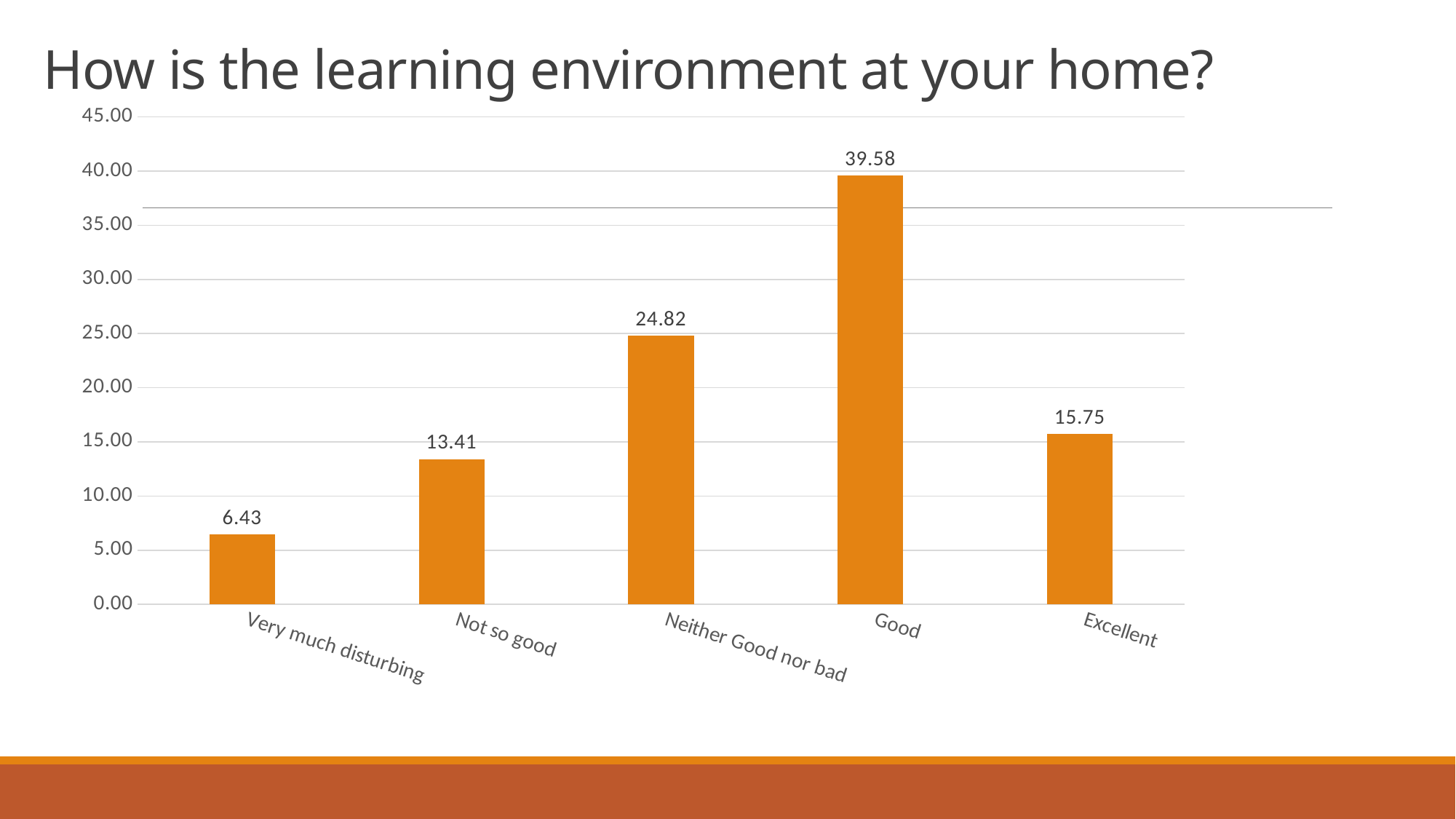
What is the title of the slide? How is the learning environment at your home? What is the value for Good? 39.58 Which category has the lowest value? Very much disturbing Is the value for Not so good greater or less than 15.00? less What is the value for Very much disturbing? 6.43 How many categories are shown on the chart? 5 Which category has the highest value? Good What is the difference between the values for Good and Neither Good nor bad? 14.76 What kind of chart is shown on the slide? bar chart Which is larger, the value for Excellent or the value for Not so good? Excellent What is the value for Neither Good nor bad? 24.82 What is the value for Excellent? 15.75